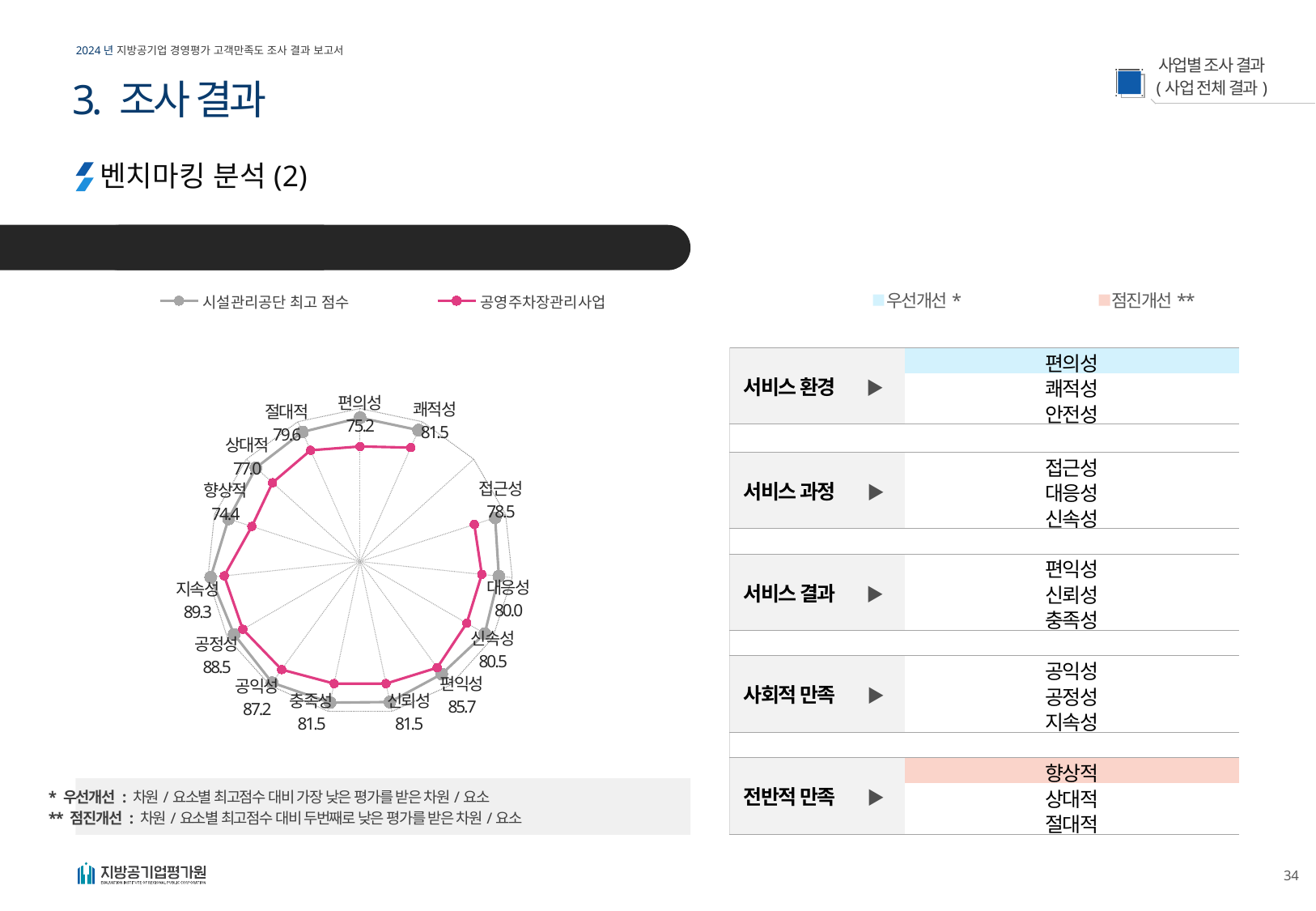
What value is labelled for 향상적 on the radar chart? 74.4 What kind of chart is shown on the left of the slide? radar chart What value is labelled for 편의성 on the radar chart? 75.2 Which category has the lowest labelled value on the radar chart? 향상적 Which category has the highest labelled value on the radar chart? 지속성 What value is labelled for 지속성 on the radar chart? 89.3 What value is labelled for 편익성 on the radar chart? 85.7 Which series is drawn in pink on the radar chart? 공영주차장관리사업 What is the difference between the labelled values for 지속성 and 향상적 on the radar chart? 14.9 Which has the larger labelled value on the radar chart, 공정성 or 공익성? 공정성 How many series does the legend of the radar chart list? 2